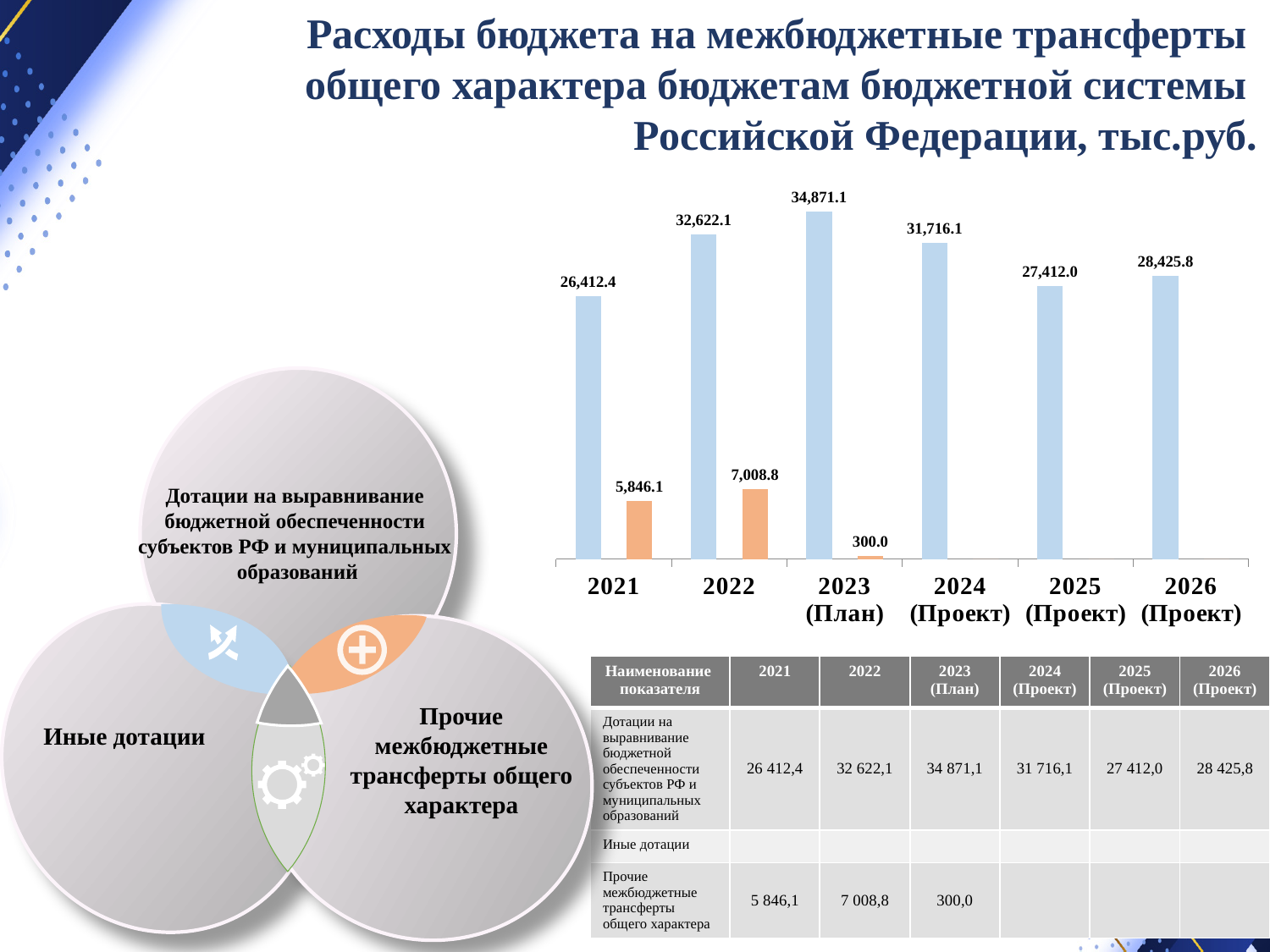
What is the value of the orange bar for 2022? 7,008.8 What is the value of the blue bar for 2026 (Проект)? 28,425.8 In which year is the blue bar the lowest? 2021 Do the blue bars rise or fall from 2021 to 2023 (План)? Rise What is the difference between the blue bar values for 2023 (План) and 2024 (Проект)? 3,155.0 Which is larger, the blue bar for 2025 (Проект) or the blue bar for 2026 (Проект)? 2026 (Проект) What is the value of the orange bar for 2023 (План)? 300.0 What is the value of the blue bar for 2023 (План)? 34,871.1 What kind of chart is shown on the slide? Bar chart How many year categories are shown on the x axis of the chart? 6 In which year is the blue bar the highest? 2023 (План) What is the difference between the orange bar values for 2022 and 2021? 1,162.7